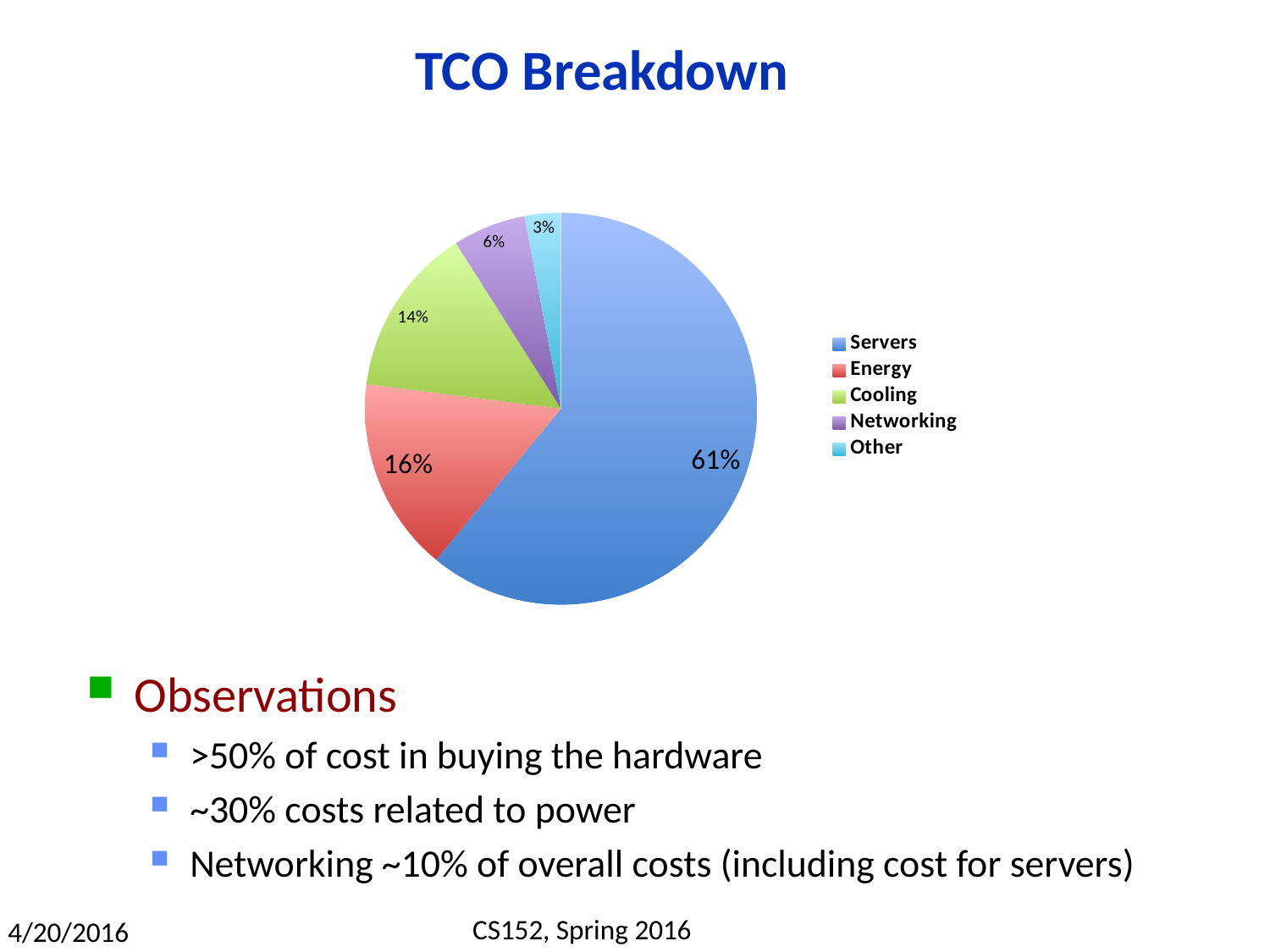
Which is larger, the Cooling slice or the Networking slice? Cooling What is the value shown for Networking? 6% How many categories does the legend list? 5 Which category has the largest slice of the pie? Servers What is the value shown for Other? 3% What is the value shown for Cooling? 14% What is the difference between the Servers share and the Energy share? 45% What is the value shown for Energy? 16% What share of the pie does Servers account for? 61% Which category has the smallest slice of the pie? Other What kind of chart is shown on the slide? pie chart What is the title of the chart? TCO Breakdown